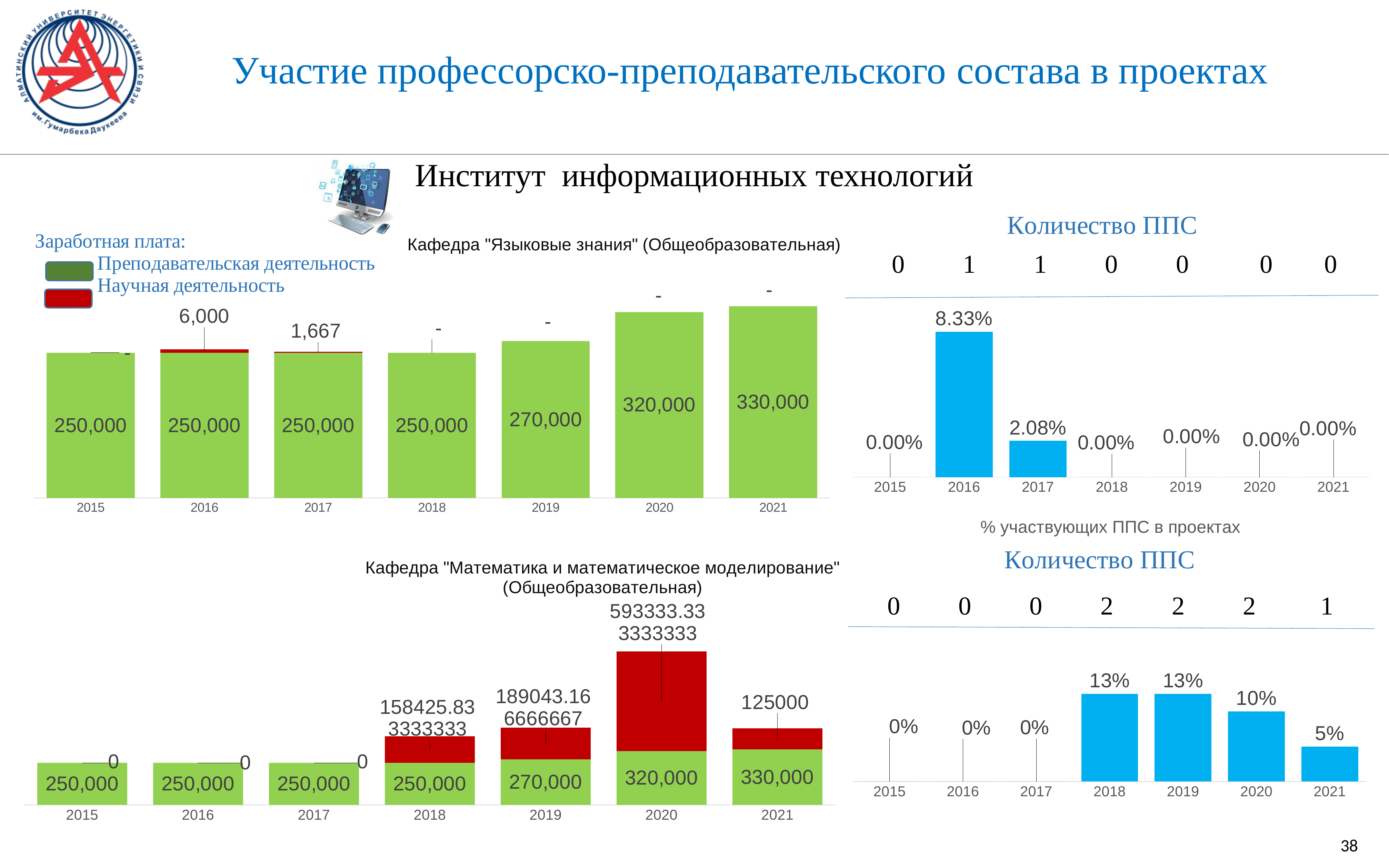
In the chart for Кафедра "Математика и математическое моделирование" (Общеобразовательная), what is the value for Научная деятельность in 2021? 125000 In the bottom-right chart (% участвующих ППС в проектах), which is larger, the value for 2018 or the value for 2021? 2018 In the chart for Кафедра "Языковые знания" (Общеобразовательная), do the Преподавательская деятельность values rise or fall from 2015 to 2021? rise In the chart for Кафедра "Языковые знания" (Общеобразовательная), what is the value for Преподавательская деятельность in 2020? 320,000 In the chart for Кафедра "Языковые знания" (Общеобразовательная), what is the difference between the Преподавательская деятельность values for 2021 and 2019? 60,000 In the top-right chart (% участвующих ППС в проектах), what is the value for 2017? 2.08% In the chart for Кафедра "Языковые знания" (Общеобразовательная), what is the value for Научная деятельность in 2016? 6,000 In the top-right chart (% участвующих ППС в проектах), which year has the highest value? 2016 In the bottom-right chart (% участвующих ППС в проектах), what is the value for 2020? 10% How many years are shown on the x axis of the chart for Кафедра "Математика и математическое моделирование" (Общеобразовательная)? 7 How many series does the Заработная плата legend list? 2 In the chart for Кафедра "Языковые знания" (Общеобразовательная), what is the total of the stacked bar for 2017? 251,667